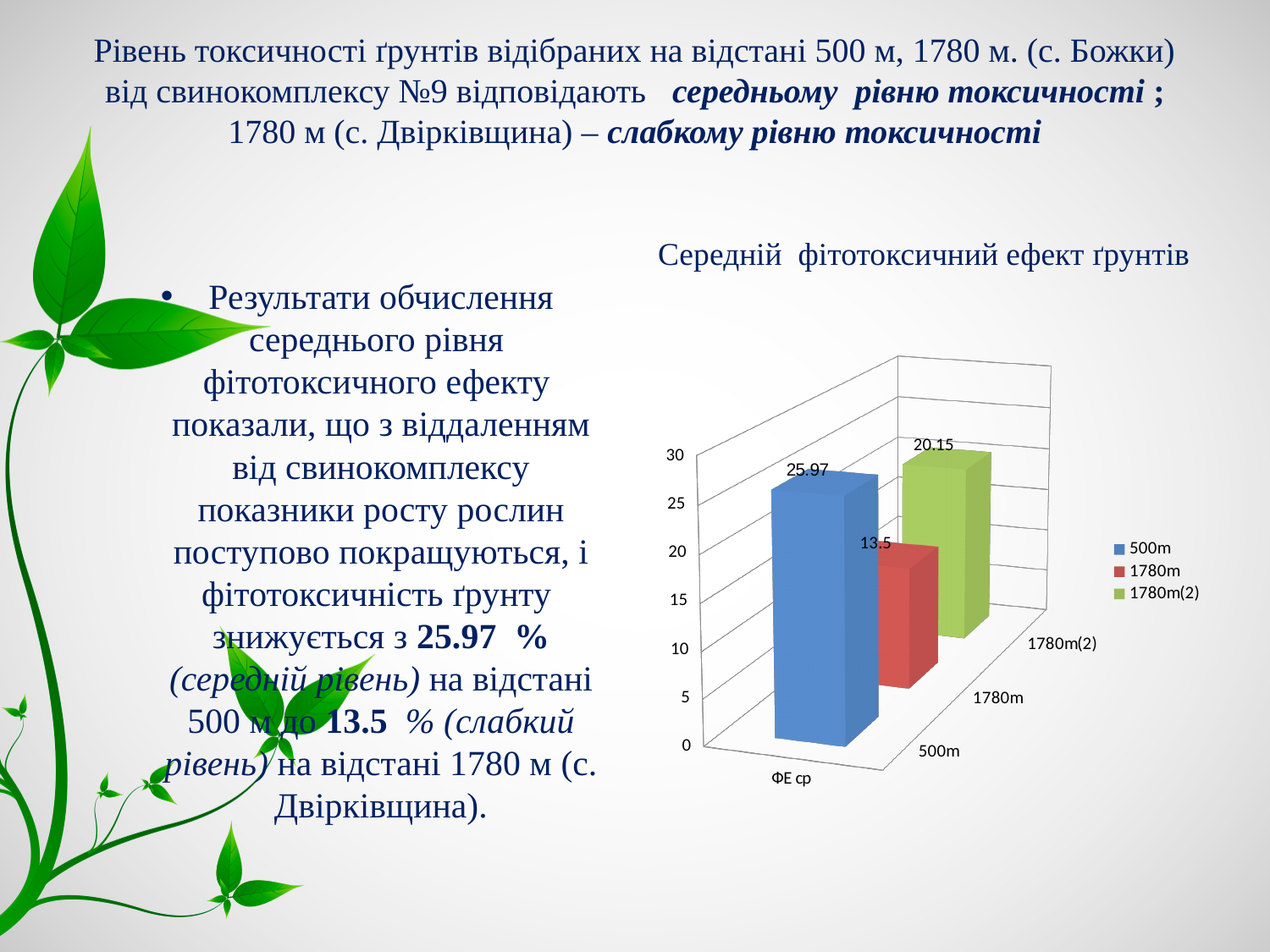
Is the value for 500m greater or less than 25? greater What is the value for the 1780m(2) series in the chart? 20.15 What is the difference between the 500m value and the 1780m value? 12.47 What kind of chart is shown on the slide? bar chart What is the difference between the 1780m(2) value and the 1780m value? 6.65 Which series has the lowest value in the chart? 1780m Which is larger, the value for 1780m(2) or the value for 1780m? 1780m(2) What is the value for the 1780m series in the chart? 13.5 Which series has the highest value in the chart? 500m What is the value for the 500m series in the chart? 25.97 How many series does the legend list? 3 What is the title of the chart? Середній фітотоксичний ефект ґрунтів